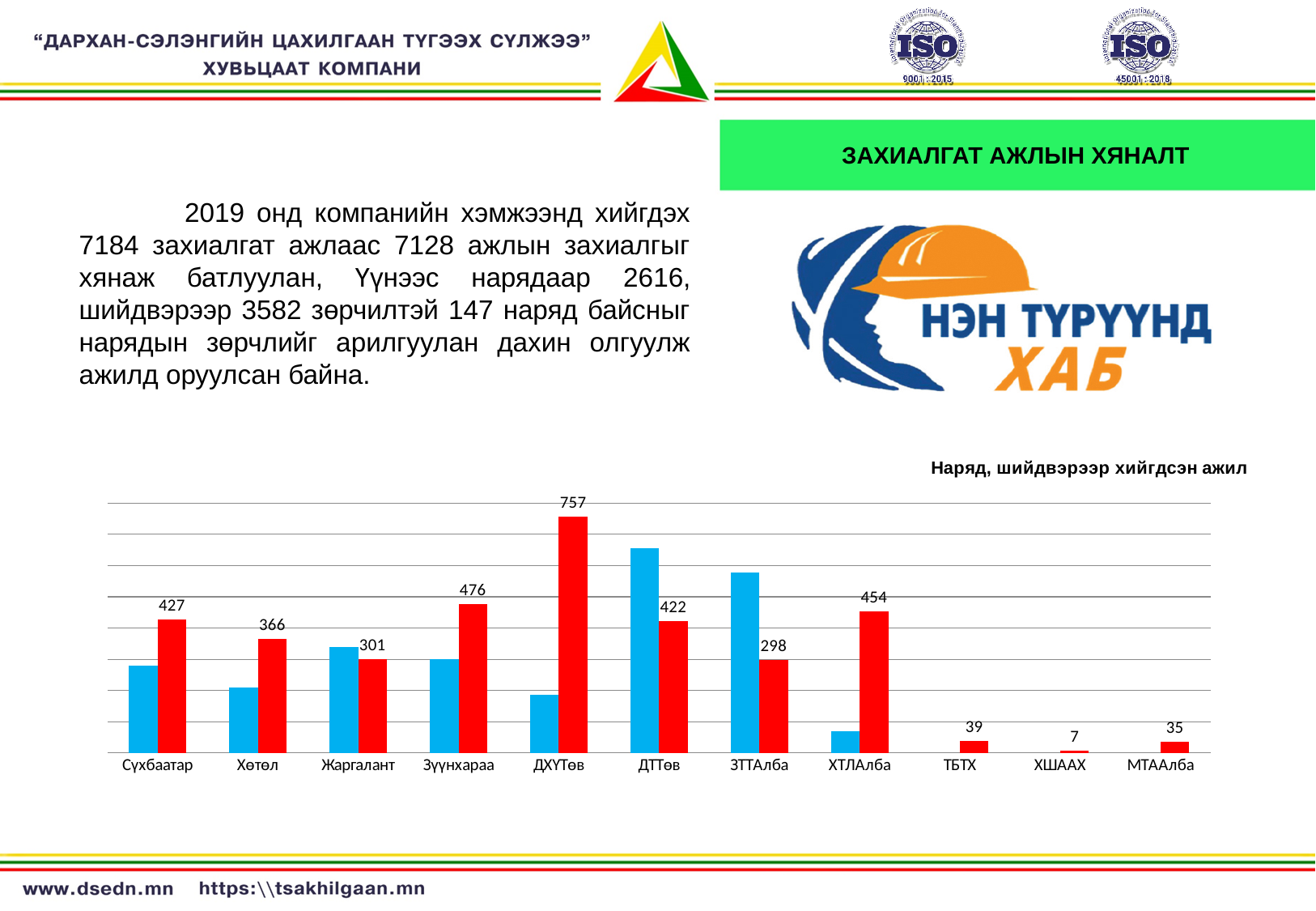
Which category has the lowest red bar? ХШААХ What is the value of the red bar for ХТЛАлба? 454 What type of chart is shown on the slide? bar chart What is the value of the red bar for Сүхбаатар? 427 How many categories are shown on the x axis of the chart? 11 Which has the larger red bar value, Хөтөл or Жаргалант? Хөтөл What is the difference between the red bar values for ТБТХ and МТААлба? 4 For ДТТөв, which bar is taller, the blue one or the red one? blue What is the value of the red bar for ДХҮТөв? 757 What is the difference between the red bar values for ДХҮТөв and Зүүнхараа? 281 What is the value of the red bar for ХШААХ? 7 Which category has the highest red bar? ДХҮТөв